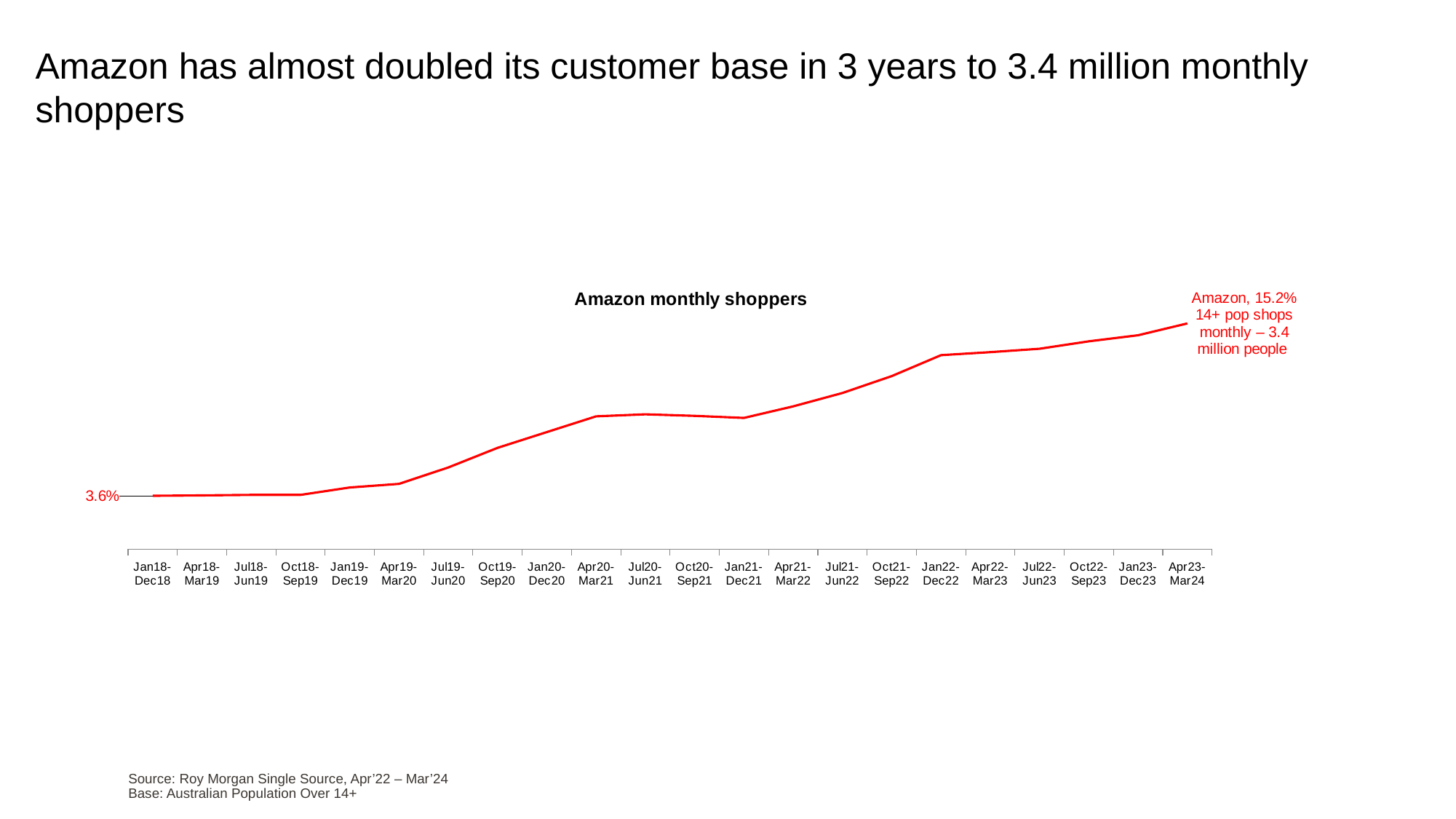
What type of chart is shown on the slide? line chart Do the values generally rise or fall from Jan18-Dec18 to Apr23-Mar24? rise Which is larger, the value for Jan22-Dec22 or the value for Jan21-Dec21? Jan22-Dec22 Which is larger, the value for Apr19-Mar20 or the value for Jan20-Dec20? Jan20-Dec20 What is the title of the chart? Amazon monthly shoppers What is the difference between the values for Apr23-Mar24 and Jan18-Dec18? 11.6 percentage points How many periods are shown on the x axis? 22 What colour is the line in the chart? red Which period has the highest value? Apr23-Mar24 What is the value for Apr23-Mar24? 15.2% What is the value for Jan18-Dec18? 3.6% According to the annotation, how many people does 15.2% of the 14+ population correspond to? 3.4 million people